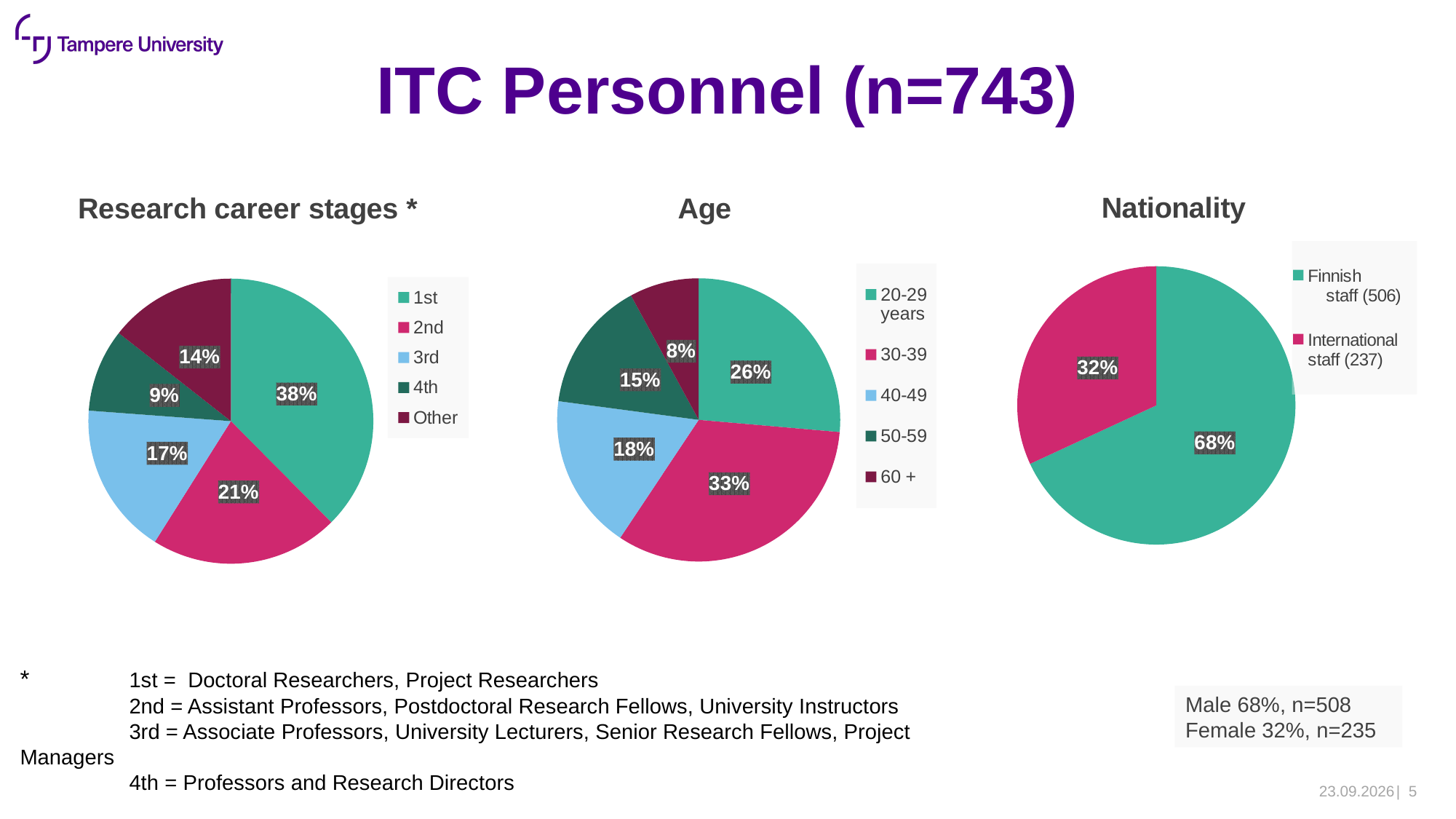
How many categories does the Research career stages pie chart show? 5 In the Age chart, what is the combined share of the 20-29 years and 30-39 groups? 59% In the Research career stages chart, which category has the smallest share? 4th In the Research career stages chart, what is the difference between the 2nd and 3rd stage shares? 4% In the Research career stages chart, what share of personnel is in the 1st career stage? 38% What type of chart is used for the Nationality data? Pie chart In the Age chart, which is larger: the share for 40-49 or the share for 50-59? 40-49 In the Age chart, what share of personnel is aged 30-39? 33% In the Nationality chart, what share of personnel is International staff? 32% In the Nationality chart, how many Finnish staff are listed in the legend? 506 In the Age chart, which age group has the smallest share? 60 + In the Age chart, which age group has the largest share? 30-39